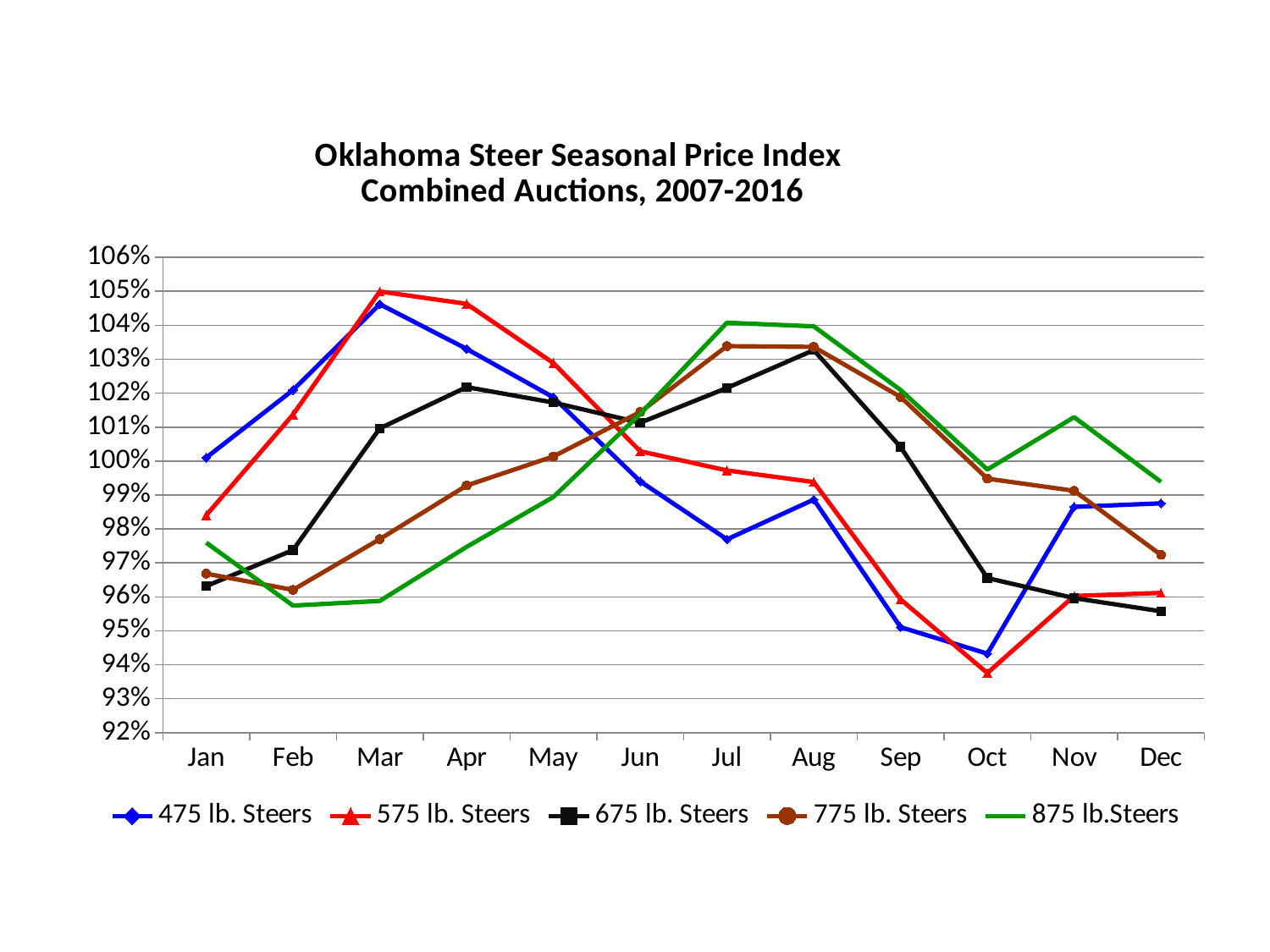
Is the value for 775 lb. Steers in Feb greater or less than 97%? less In which month is the 675 lb. Steers index highest? Aug Is the value for 575 lb. Steers in Oct greater or less than 94%? less Does the 675 lb. Steers index rise or fall from Aug to Dec? fall In Jan, which is larger: the 475 lb. Steers index or the 675 lb. Steers index? 475 lb. Steers Is the value for 875 lb.Steers in Jul greater or less than 103%? greater What kind of chart is shown on the slide? line chart In which month is the 475 lb. Steers index highest? Mar How many series does the legend list? 5 In which month is the 575 lb. Steers index lowest? Oct Which series is drawn with the green line? 875 lb.Steers How many months are plotted along the x axis? 12